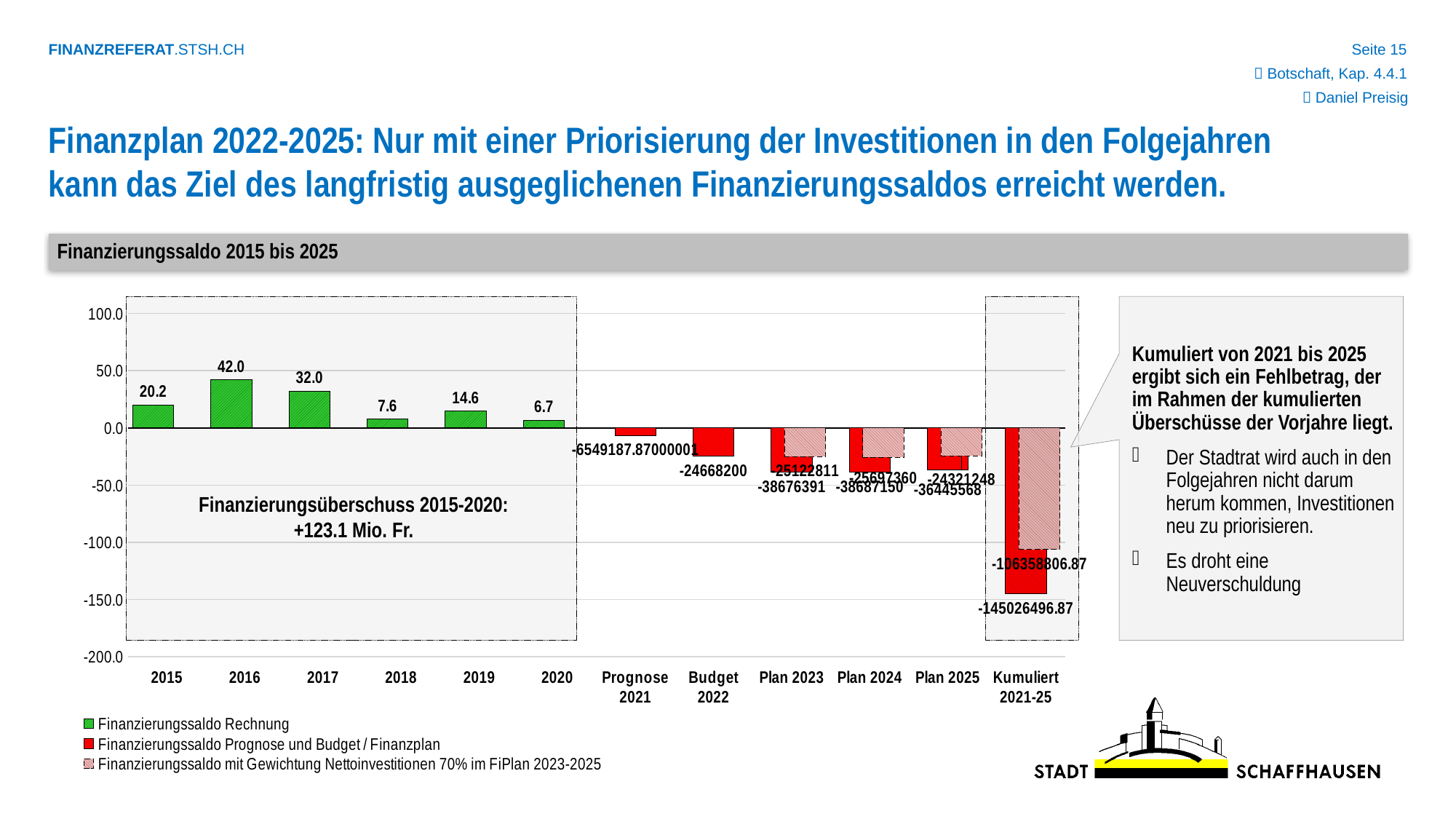
Which is larger, the Finanzierungssaldo Rechnung for 2015 or for 2019? 2015 Which year from 2015 to 2020 has the highest Finanzierungssaldo Rechnung? 2016 What is the difference between the Finanzierungssaldo Rechnung values for 2016 and 2017? 10.0 Which year from 2015 to 2020 has the lowest Finanzierungssaldo Rechnung? 2020 How many series does the legend list? 3 What is the Finanzierungssaldo Prognose und Budget / Finanzplan value labelled for Kumuliert 2021-25? -145026496.87 What kind of chart is shown on the slide? Bar chart What is the Finanzierungssaldo Rechnung value for 2016? 42.0 What is the Finanzierungssaldo Rechnung value for 2018? 7.6 Do the Finanzierungssaldo Rechnung values rise or fall from 2016 to 2018? Fall What is the Finanzierungssaldo Prognose und Budget / Finanzplan value labelled for Budget 2022? -24668200 How many categories are shown on the x axis of the chart? 12